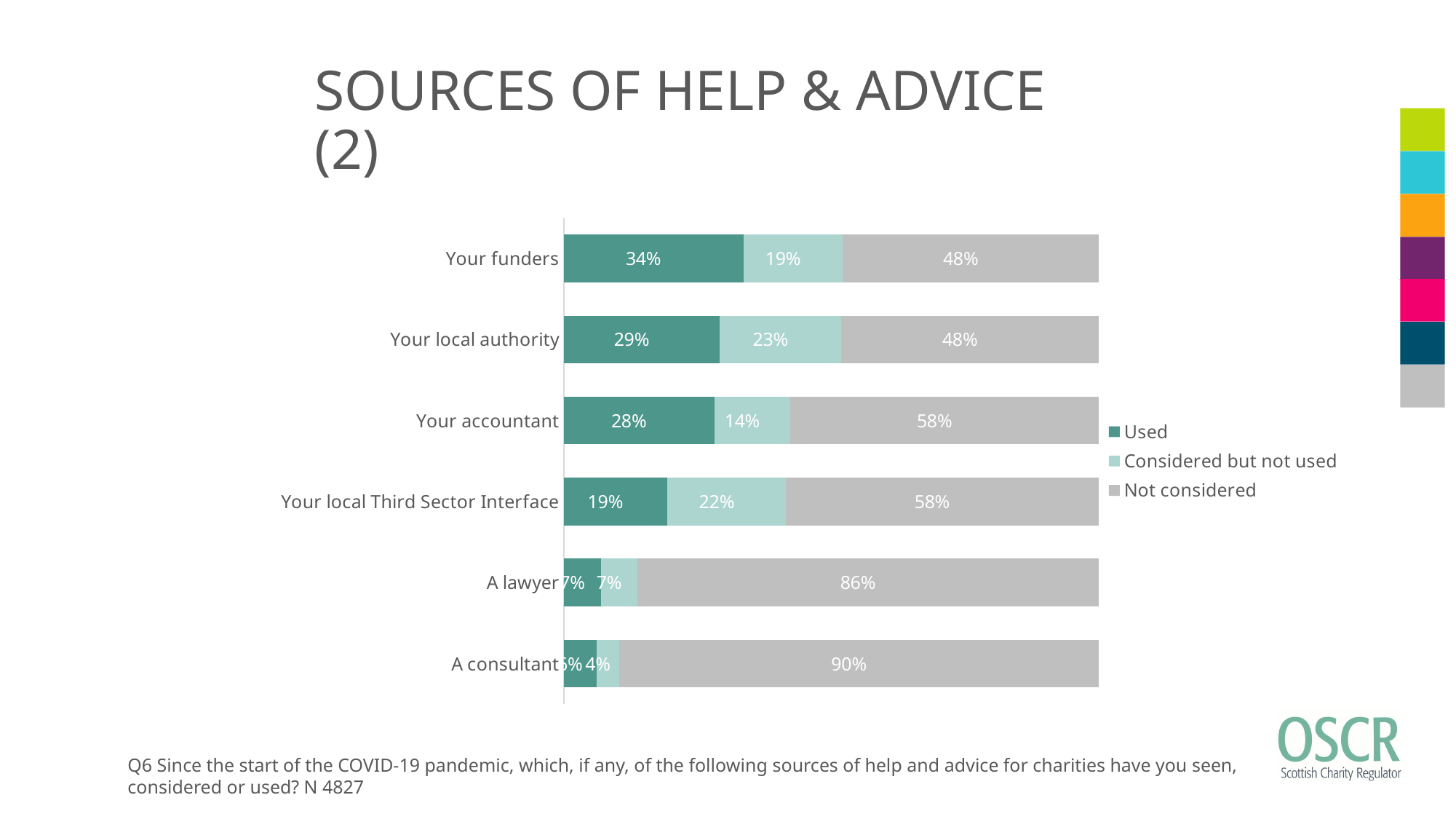
How many series does the legend list? 3 Which source has the highest 'Not considered' percentage? A consultant How many sources of help and advice are listed on the chart? 6 What is the 'Used' value for Your local Third Sector Interface? 19% Which source has the highest 'Used' percentage? Your funders Which is larger: the 'Considered but not used' value for Your accountant or for Your local Third Sector Interface? Your local Third Sector Interface What kind of chart is shown on the slide? Stacked bar chart What percentage of respondents used their funders as a source of help and advice? 34% What is the 'Considered but not used' value for Your local authority? 23% What is the 'Not considered' value for A lawyer? 86% Which legend entry is shown in grey? Not considered What is the difference between the 'Used' values for Your funders and Your accountant? 6%